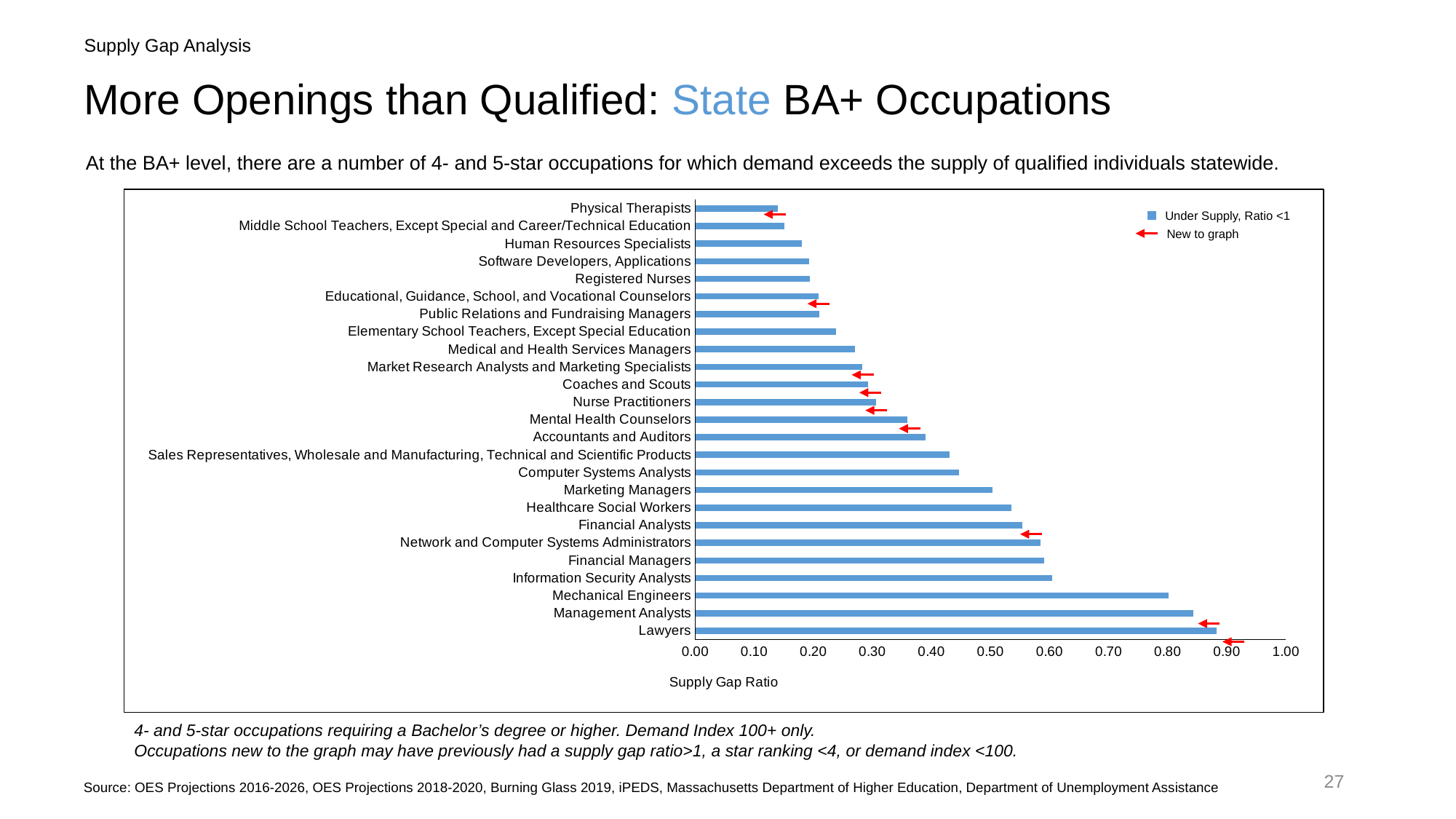
How many occupations are plotted in the chart? 25 Is the supply gap ratio for Mechanical Engineers greater or less than 0.70? greater What kind of chart is shown on the slide? Bar chart Which occupation has the highest supply gap ratio in the chart? Lawyers Which has a larger supply gap ratio, Healthcare Social Workers or Elementary School Teachers, Except Special Education? Healthcare Social Workers Is the supply gap ratio for Lawyers greater or less than 0.80? greater Is the supply gap ratio for Accountants and Auditors greater or less than 0.30? greater Which has a larger supply gap ratio, Mechanical Engineers or Financial Managers? Mechanical Engineers What is the title of the horizontal axis of the chart? Supply Gap Ratio Which occupation has the lowest supply gap ratio in the chart? Physical Therapists